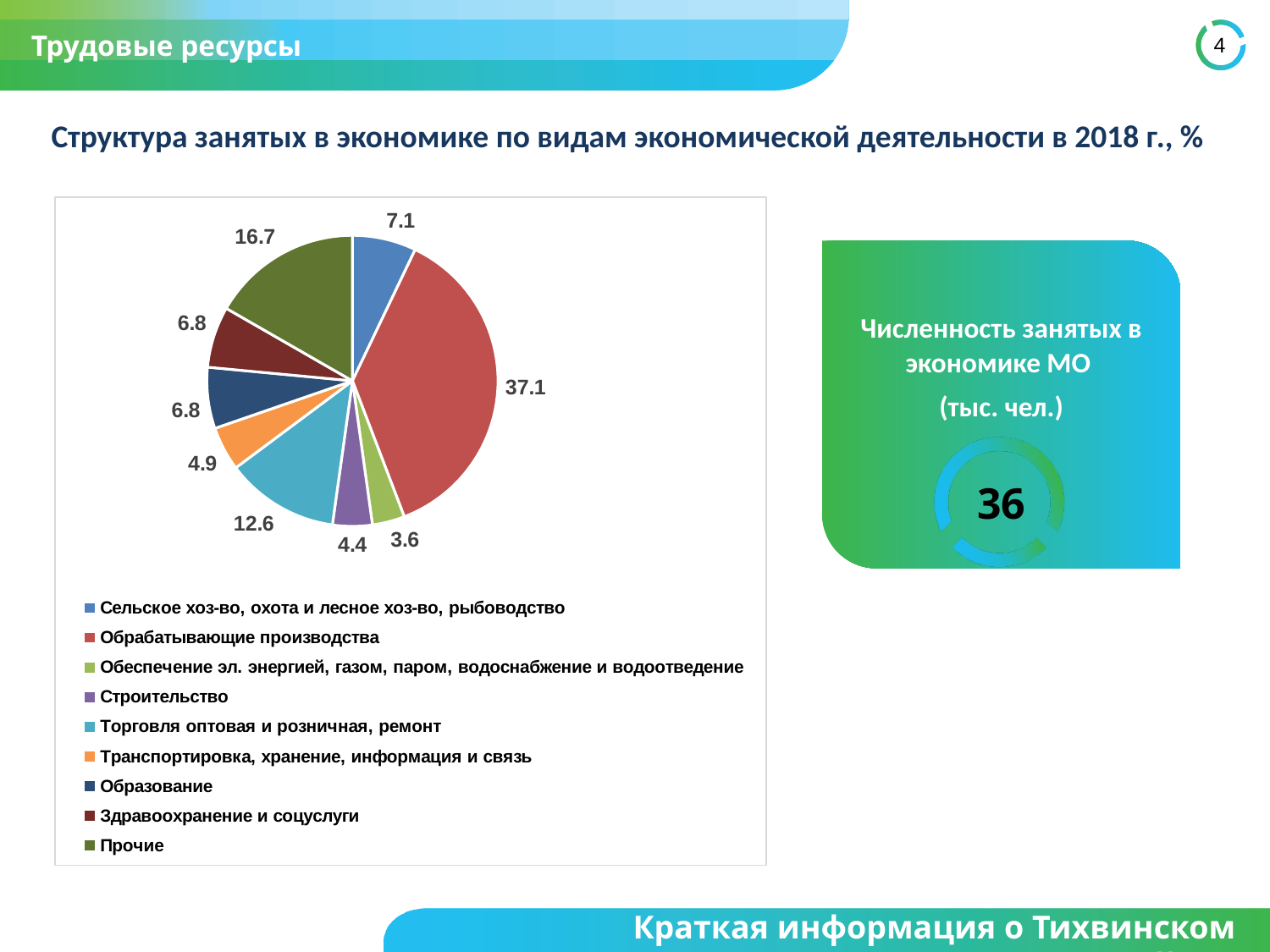
What is the title of the chart? Структура занятых в экономике по видам экономической деятельности в 2018 г., % What is the difference between the values for Обрабатывающие производства and Прочие? 20.4 What type of chart is shown on the slide? pie chart What is the value for Строительство? 4.4 What is the value for Прочие? 16.7 Which category has the largest share of the pie? Обрабатывающие производства Which category has the smallest share of the pie? Обеспечение эл. энергией, газом, паром, водоснабжение и водоотведение What is the value for Обрабатывающие производства? 37.1 What is the value for Торговля оптовая и розничная, ремонт? 12.6 What is the value for Образование? 6.8 Which is larger, the value for Сельское хоз-во, охота и лесное хоз-во, рыбоводство or the value for Транспортировка, хранение, информация и связь? Сельское хоз-во, охота и лесное хоз-во, рыбоводство How many categories does the pie chart have? 9